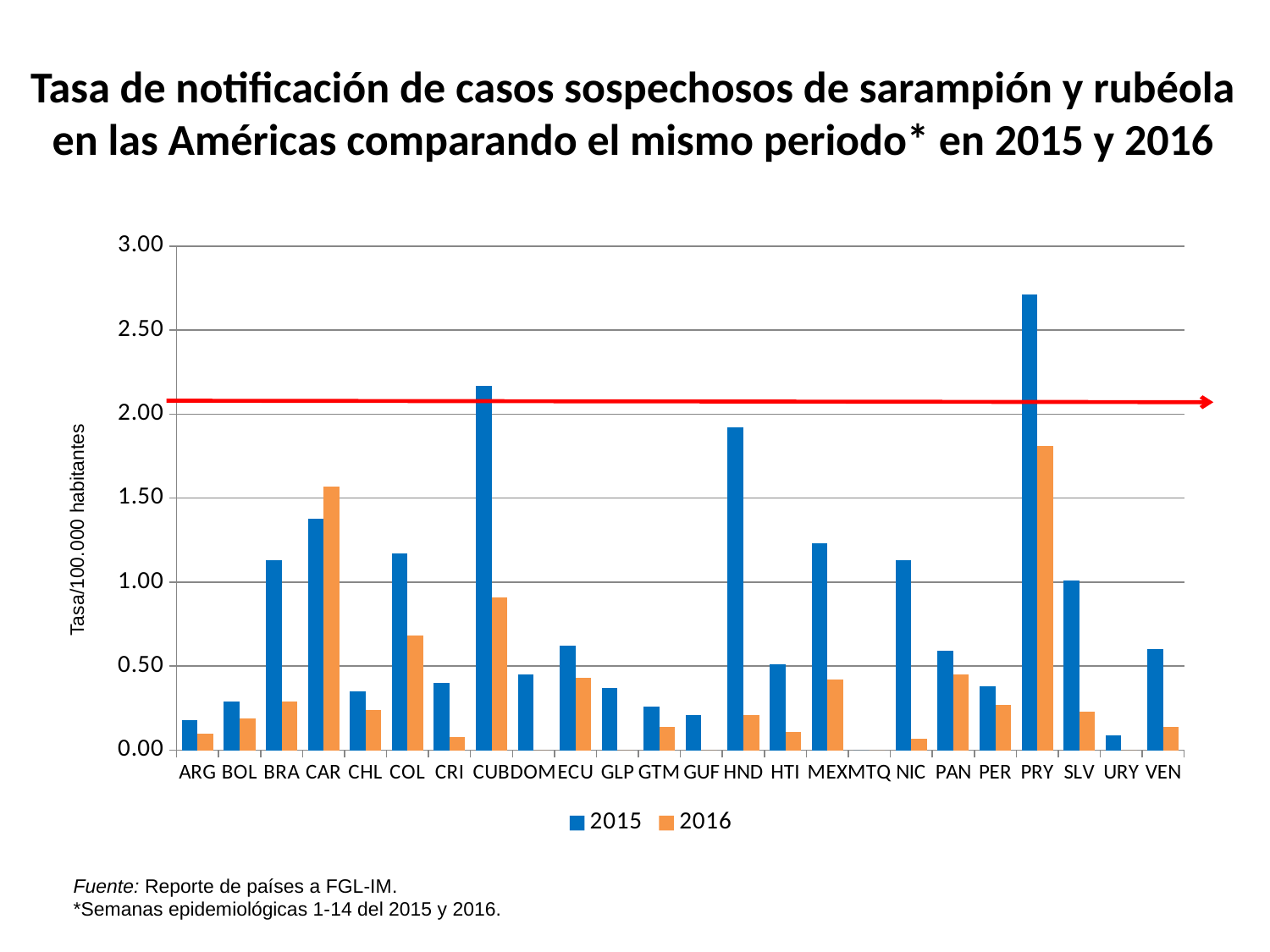
Is the 2016 value for CUB greater or less than 0.50? greater For CAR, which is larger: the 2015 value or the 2016 value? 2016 Which country has the highest 2015 value? PRY Is the 2015 value for HND greater or less than 2.00? less How many series does the legend list? 2 Is the 2016 value for CAR greater or less than 1.50? greater Which country has the highest 2016 value? PRY How many countries or territories are shown on the x axis? 24 Which country has the lowest 2015 value? MTQ What is the label on the y axis? Tasa/100.000 habitantes What kind of chart is shown on the slide? bar chart